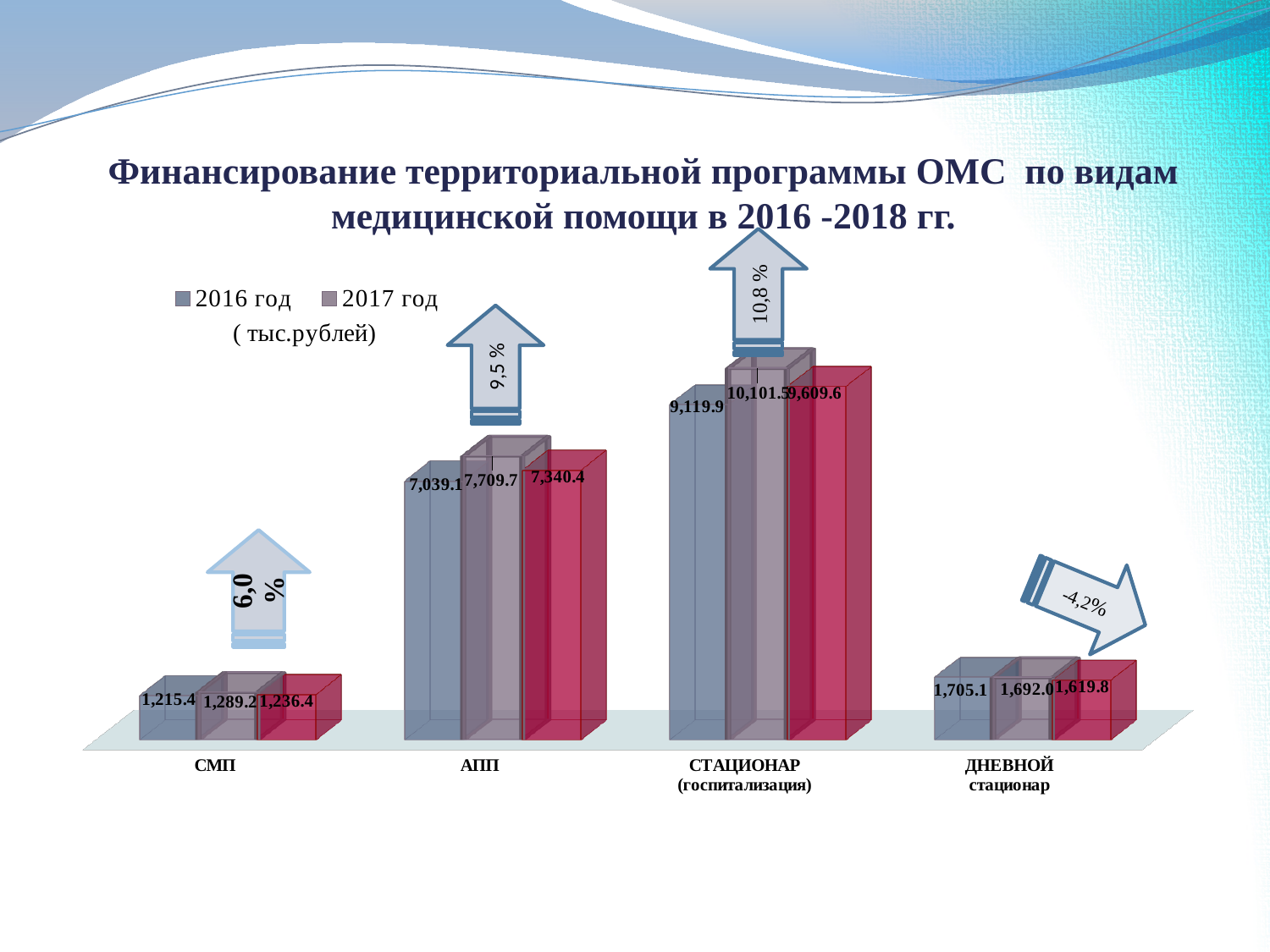
How many categories are shown on the x axis? 4 What is the 2016 год value for ДНЕВНОЙ стационар? 1,705.1 What is the difference between the 2017 год and 2016 год values for АПП? 670.6 What is the 2017 год value for СТАЦИОНАР (госпитализация)? 10,101.5 What is the 2017 год value for СМП? 1,289.2 How many series does the legend list? 2 For ДНЕВНОЙ стационар, which is larger: the 2016 год value or the 2017 год value? 2016 год What kind of chart is shown on the slide? bar chart Which category has the lowest 2016 год value? СМП What is the difference between the 2017 год and 2016 год values for СТАЦИОНАР (госпитализация)? 981.6 What is the 2016 год value for АПП? 7,039.1 Which category has the highest 2017 год value? СТАЦИОНАР (госпитализация)